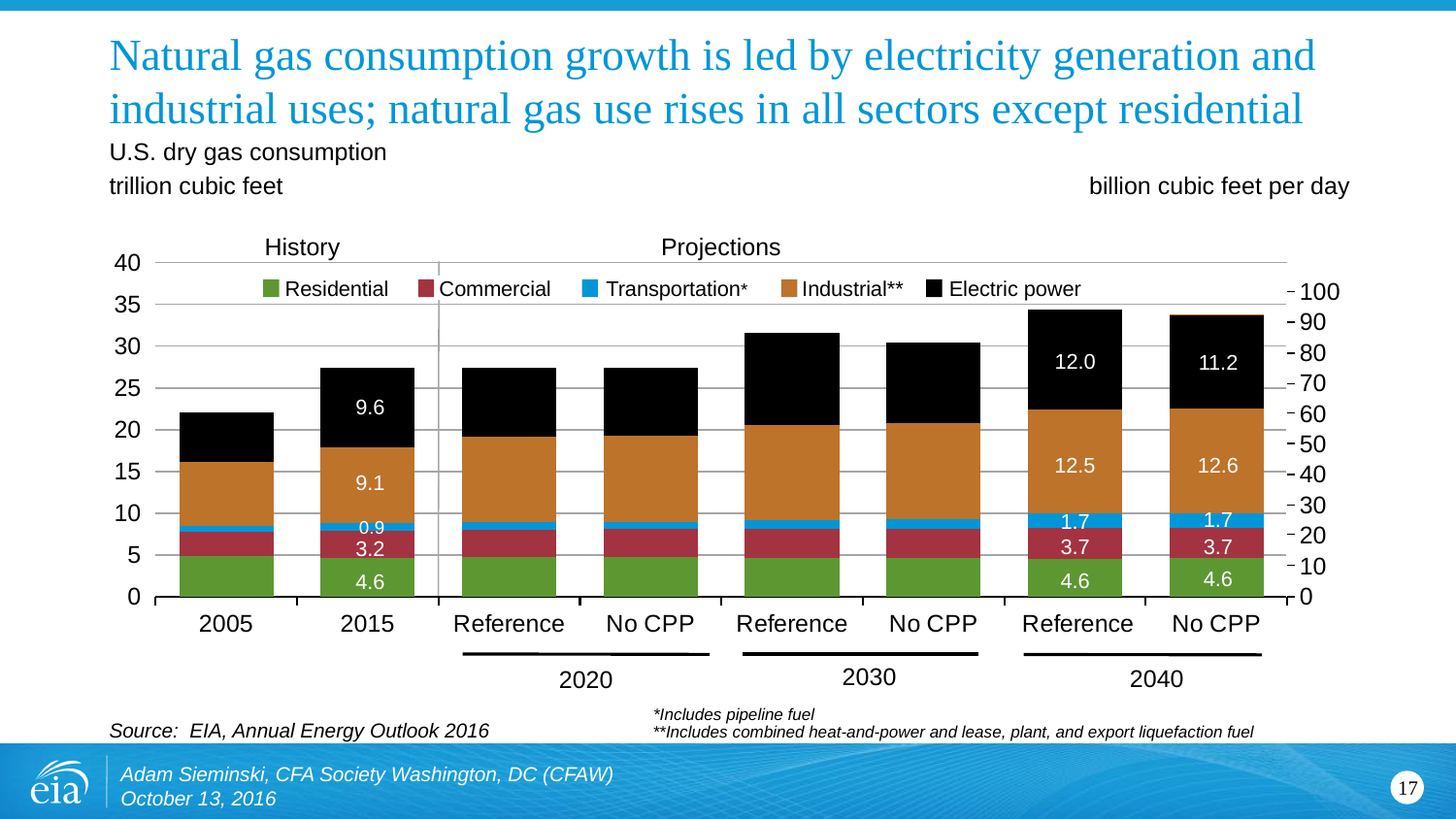
Which bar is the tallest in the chart? 2040 Reference What is the Industrial value for the 2040 Reference case? 12.5 Is the total height of the 2005 bar greater or less than 20 on the left axis? greater What is the Transportation value for the 2040 No CPP case? 1.7 How many stacked bars are plotted in the chart? 8 What is the difference between the Electric power values for the 2040 Reference case and the 2040 No CPP case? 0.8 What unit is shown on the left axis of the chart? trillion cubic feet What is the Electric power value for 2015? 9.6 What kind of chart is shown on the slide? Stacked bar chart In 2015, which is larger: the Industrial value or the Electric power value? Electric power How many series does the legend list? 5 What is the total of the 2015 stacked bar? 27.4